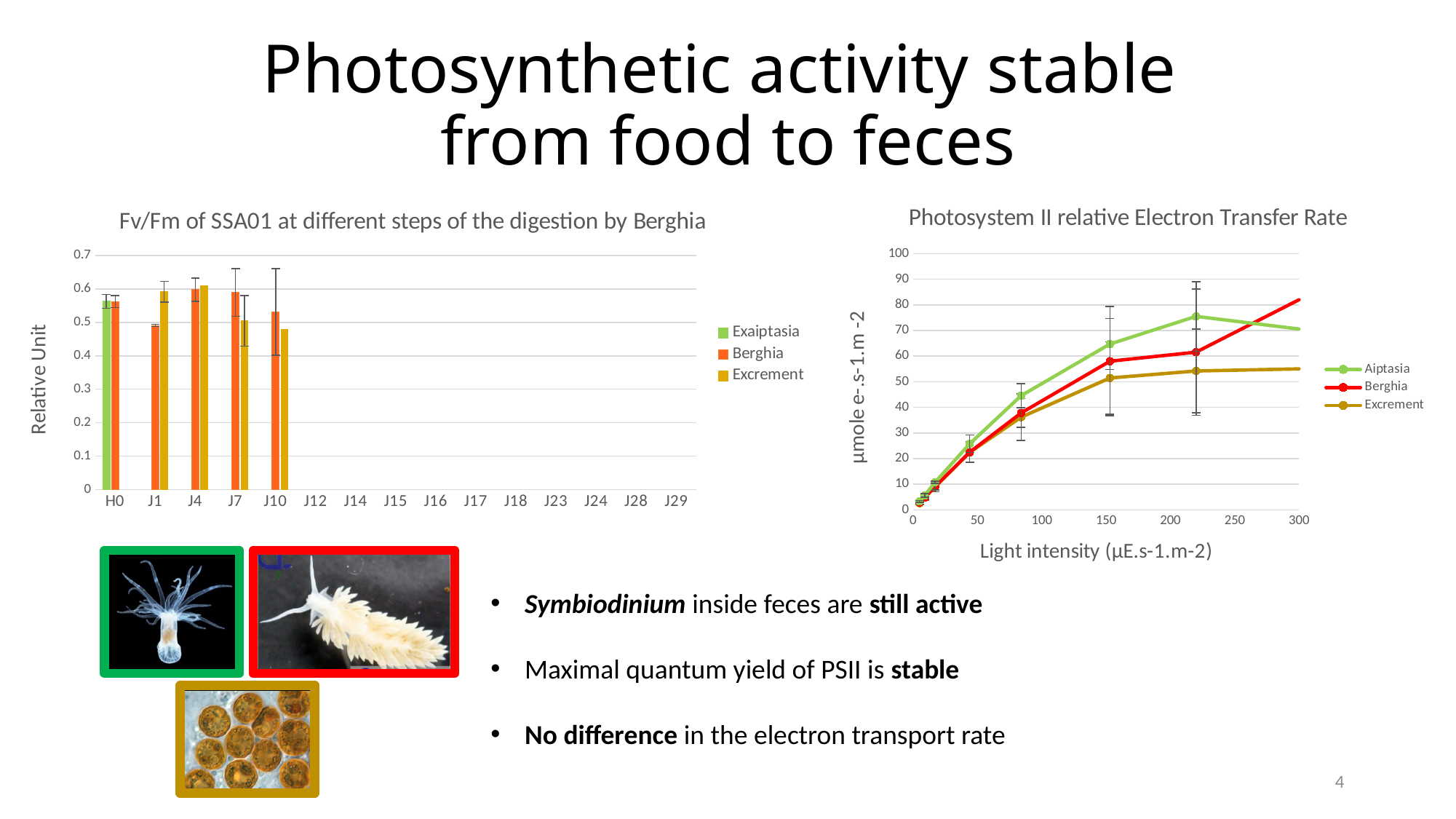
In the right chart (Photosystem II relative Electron Transfer Rate), which series does the legend list in red? Berghia What kind of chart is the right chart titled 'Photosystem II relative Electron Transfer Rate'? line chart In the left chart (Fv/Fm of SSA01), how many series does the legend list? 3 In the left chart (Fv/Fm of SSA01), is the Berghia value at H0 greater or less than 0.5? greater In the right chart (Photosystem II relative Electron Transfer Rate), is the Aiptasia value at a light intensity of 220 greater or less than 70? greater In the left chart (Fv/Fm of SSA01), at J1, which is larger: the Berghia value or the Excrement value? Excrement What kind of chart is the left chart titled 'Fv/Fm of SSA01 at different steps of the digestion by Berghia'? bar chart In the left chart (Fv/Fm of SSA01), how many categories are shown on the x axis? 15 In the right chart (Photosystem II relative Electron Transfer Rate), is the Excrement value at a light intensity of 300 greater or less than 60? less In the right chart (Photosystem II relative Electron Transfer Rate), does the Excrement series rise or fall as light intensity increases from 0 to 300? rise In the right chart (Photosystem II relative Electron Transfer Rate), which series has the highest value at a light intensity of 300? Berghia